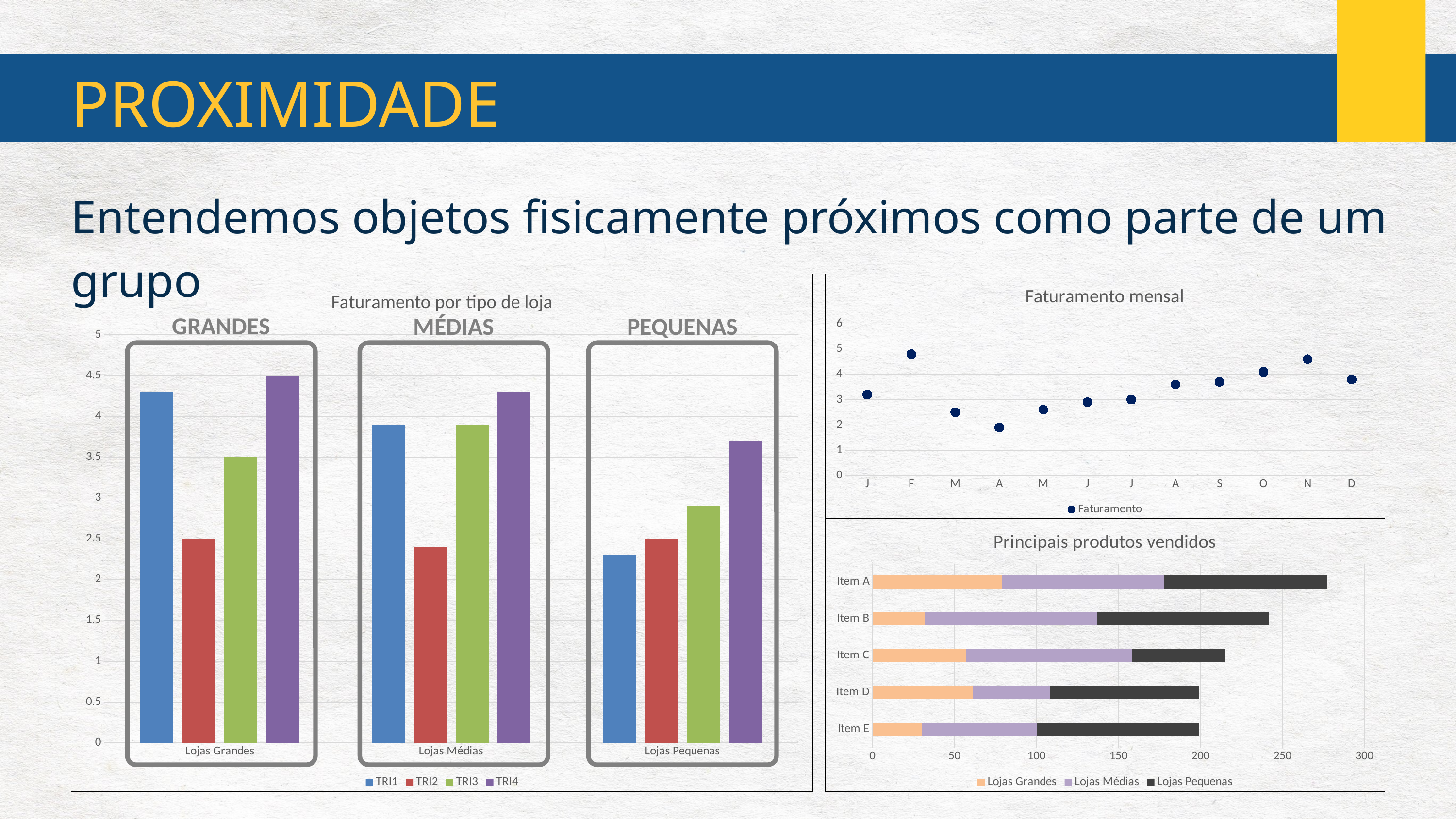
How many series does the legend of 'Faturamento por tipo de loja' list? 4 In 'Faturamento por tipo de loja', which series has the lowest value for Lojas Pequenas? TRI1 In 'Principais produtos vendidos', which item has the longest total bar? Item A How many series does the legend of 'Principais produtos vendidos' list? 3 What kind of chart is 'Faturamento por tipo de loja'? bar chart In 'Faturamento por tipo de loja', which is larger: the TRI1 value for Lojas Grandes or the TRI1 value for Lojas Médias? Lojas Grandes How many data points are plotted in 'Faturamento mensal'? 12 How many store-type categories are shown on the x axis of 'Faturamento por tipo de loja'? 3 In 'Faturamento por tipo de loja', is the TRI1 value for Lojas Médias greater or less than 3.5? greater In 'Faturamento mensal', which month has the lowest value? A In 'Faturamento por tipo de loja', which series has the highest value for Lojas Grandes? TRI4 In 'Faturamento mensal', is the value for M (March) greater or less than 3? less